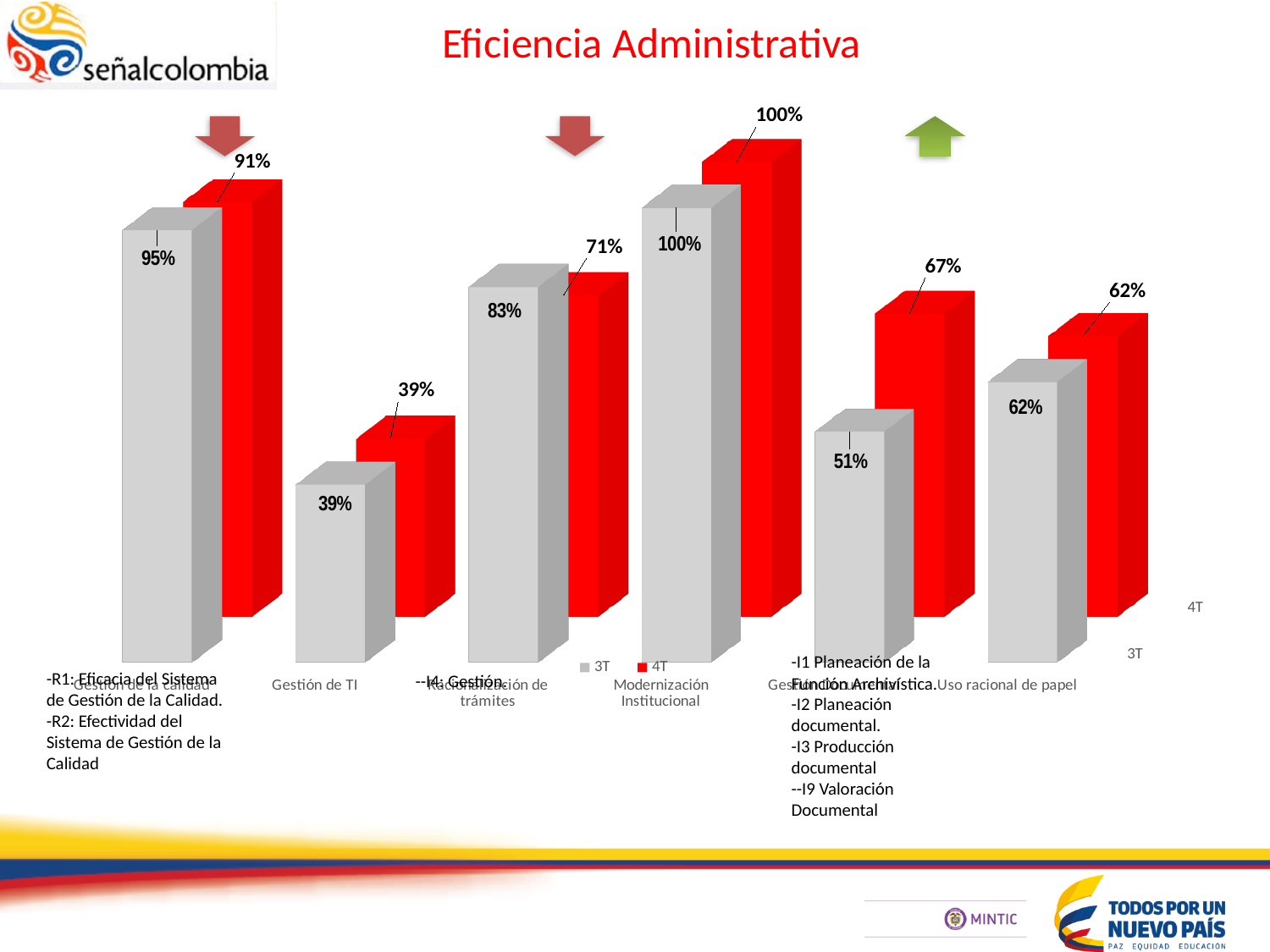
What is the 4T value for Uso racional de papel? 62% Which is larger for Uso racional de papel: the 3T value or the 4T value? They are equal (62%) How many categories are shown on the x axis of the chart? 6 What type of chart is shown on the slide? bar chart What is the 3T value for Modernización Institucional? 100% Which colour represents the 4T series in the chart? red What is the difference between the 3T and 4T values for Gestión de la Calidad? 4% What is the 4T value for Gestión de TI? 39% What is the 3T value for Gestión de la Calidad? 95% How many series does the legend list? 2 Which category has the lowest 3T value? Gestión de TI Which category has the highest 4T value? Modernización Institucional